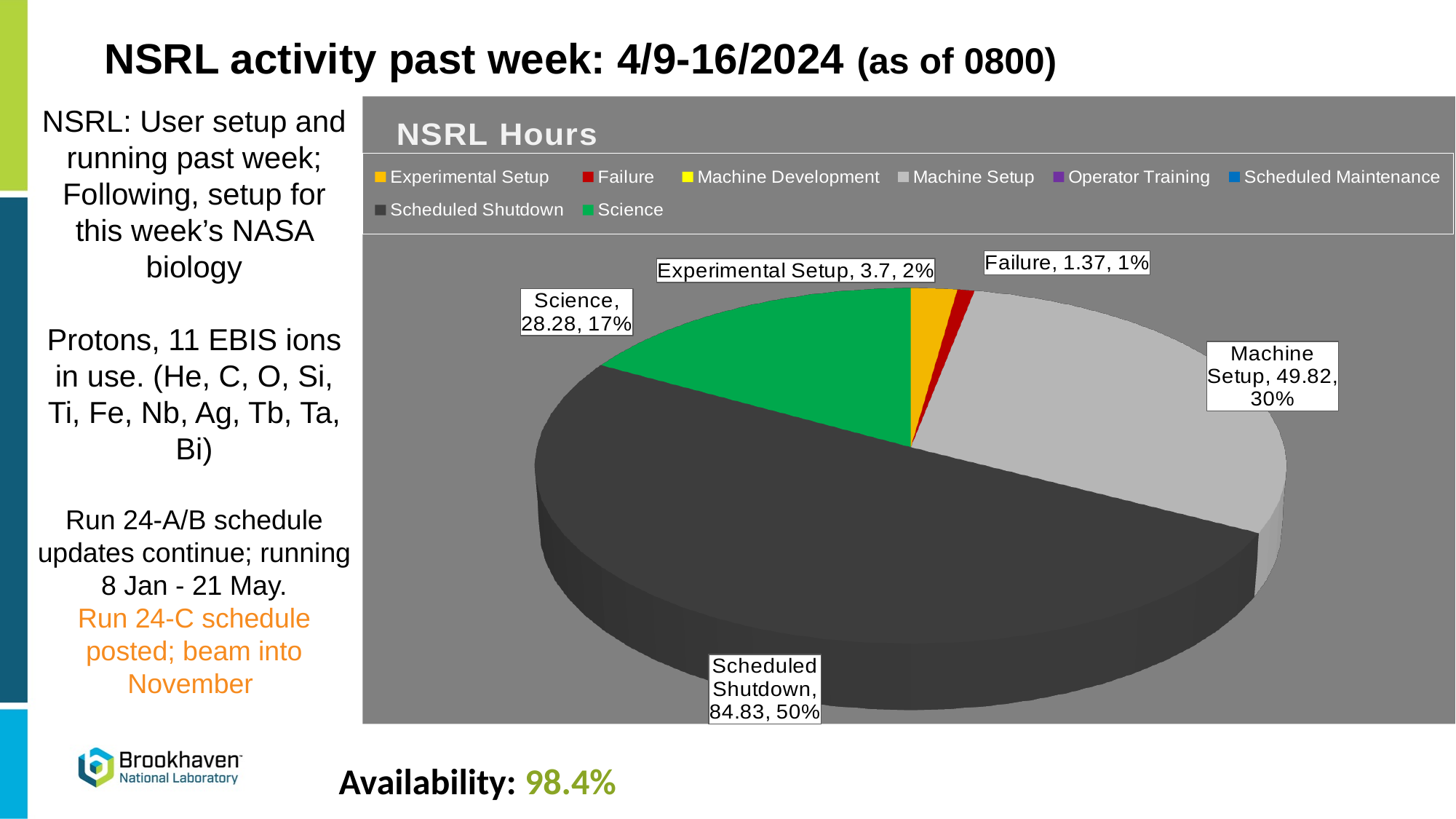
What is the title of the chart? NSRL Hours How many hours are labelled for Scheduled Shutdown? 84.83 How many entries does the chart legend list? 8 What is the difference in hours between Machine Setup and Science? 21.54 What type of chart is shown on the slide? pie chart What percentage share of the pie does Failure have? 1% Which labelled category has the smallest slice of the pie? Failure How many hours are labelled for Machine Setup? 49.82 Which category has the largest slice of the pie? Scheduled Shutdown Which has more hours, Science or Experimental Setup? Science What percentage share of the pie does Experimental Setup have? 2% How many hours are labelled for Science? 28.28